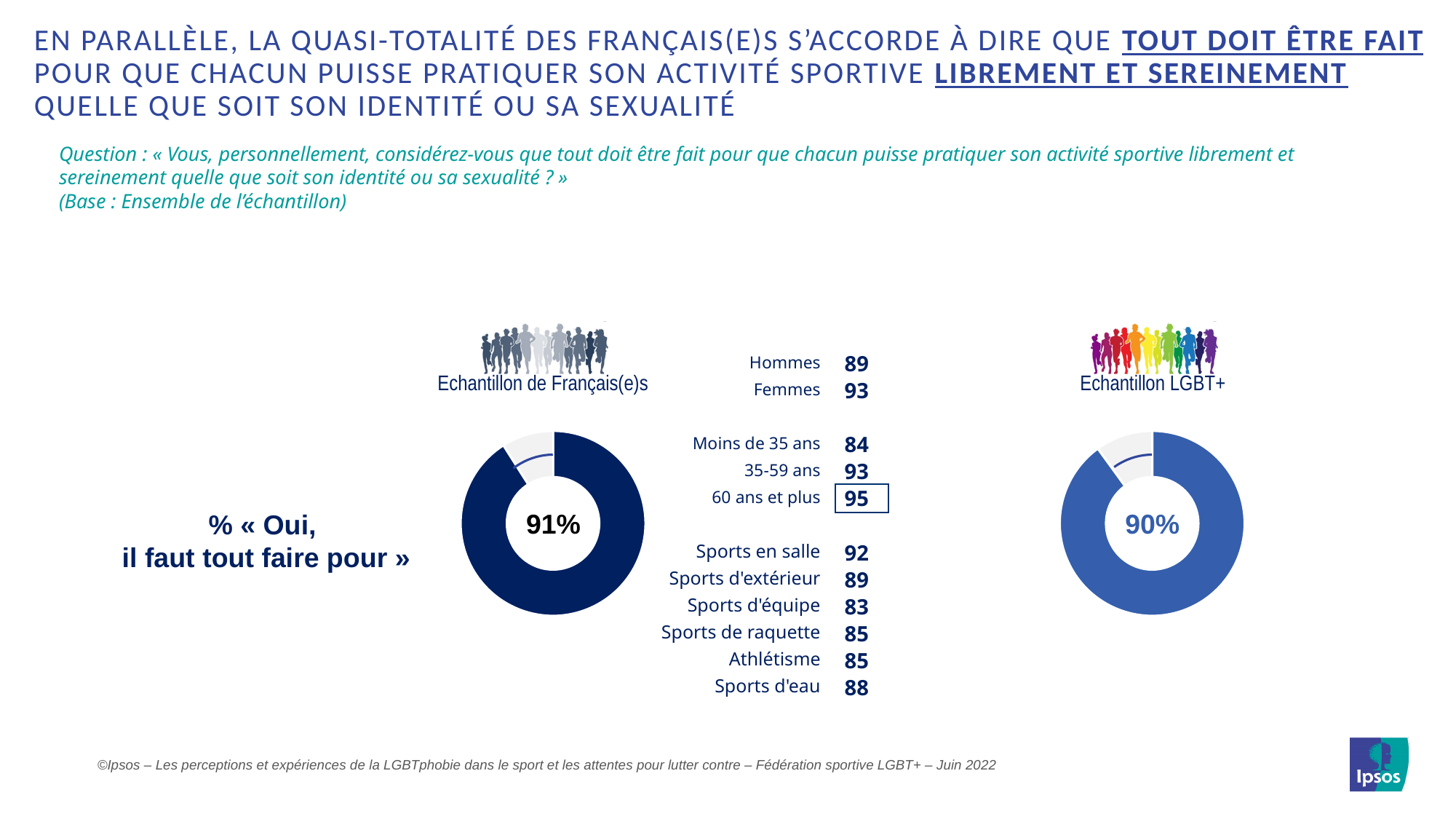
In the breakdown next to the 'Echantillon de Français(e)s' chart, what is the value for 'Femmes'? 93 In the breakdown next to the 'Echantillon de Français(e)s' chart, which sport category has the lowest value? Sports d'équipe Which sample shows the higher share of 'Oui' answers, 'Echantillon de Français(e)s' or 'Echantillon LGBT+'? Echantillon de Français(e)s In the 'Echantillon de Français(e)s' donut chart, what percentage answered 'Oui, il faut tout faire pour'? 91% What label is written to the left of the donut charts describing what the percentages represent? % « Oui, il faut tout faire pour » In the breakdown next to the 'Echantillon de Français(e)s' chart, what is the difference between 'Femmes' (93) and 'Hommes' (89)? 4 How many donut charts are shown on the slide? 2 In the 'Echantillon LGBT+' donut chart, what percentage answered 'Oui, il faut tout faire pour'? 90% What kind of chart is used for the 'Echantillon de Français(e)s' sample? Donut (pie) chart In the 'Echantillon de Français(e)s' donut chart, is the 'Oui' share greater or less than 50%? greater In the breakdown next to the 'Echantillon de Français(e)s' chart, which age group has the highest value? 60 ans et plus What is the difference in percentage points between the 'Echantillon de Français(e)s' value (91%) and the 'Echantillon LGBT+' value (90%)? 1 percentage point